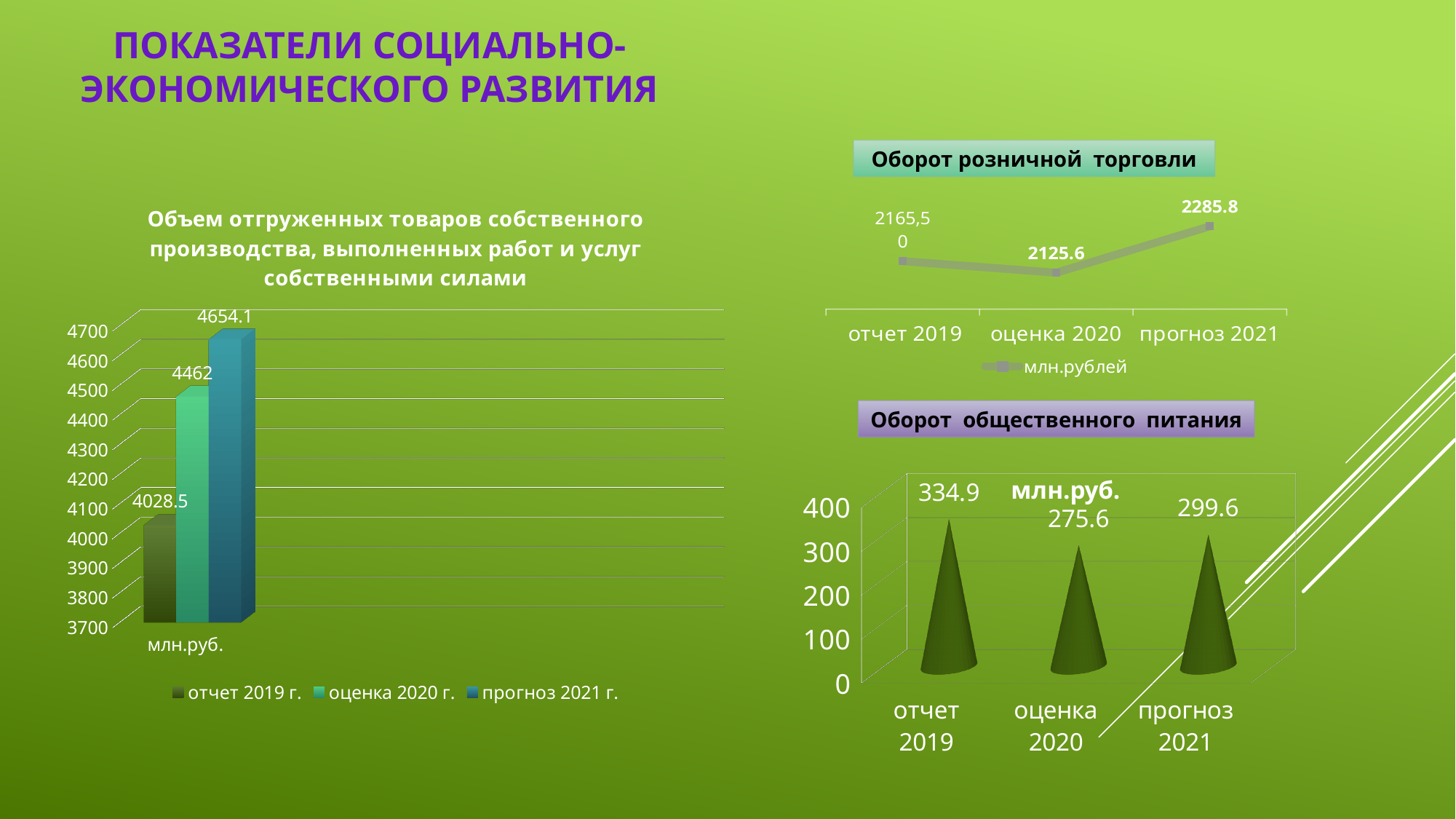
What kind of chart is 'Объем отгруженных товаров собственного производства...'? bar chart In the chart 'Оборот розничной торговли', which period has the lowest value? оценка 2020 In the chart 'Объем отгруженных товаров собственного производства...', what is the value for 'прогноз 2021 г.'? 4654.1 In the chart 'Объем отгруженных товаров собственного производства...', what is the difference between 'прогноз 2021 г.' and 'отчет 2019 г.'? 625.6 In the chart 'Оборот общественного питания', what is the difference between 'отчет 2019' and 'прогноз 2021'? 35.3 In the chart 'Оборот розничной торговли', what is the difference between 'прогноз 2021' and 'оценка 2020'? 160.2 In the chart 'Оборот общественного питания', which period has the highest value? отчет 2019 What kind of chart is 'Оборот розничной торговли'? line chart In the chart 'Объем отгруженных товаров собственного производства, выполненных работ и услуг собственными силами', what is the value for 'отчет 2019 г.'? 4028.5 In the chart 'Оборот общественного питания', what is the value for 'оценка 2020'? 275.6 In the chart 'Объем отгруженных товаров собственного производства...', how many entries does the legend list? 3 In the chart 'Оборот розничной торговли', what is the value for 'прогноз 2021'? 2285.8